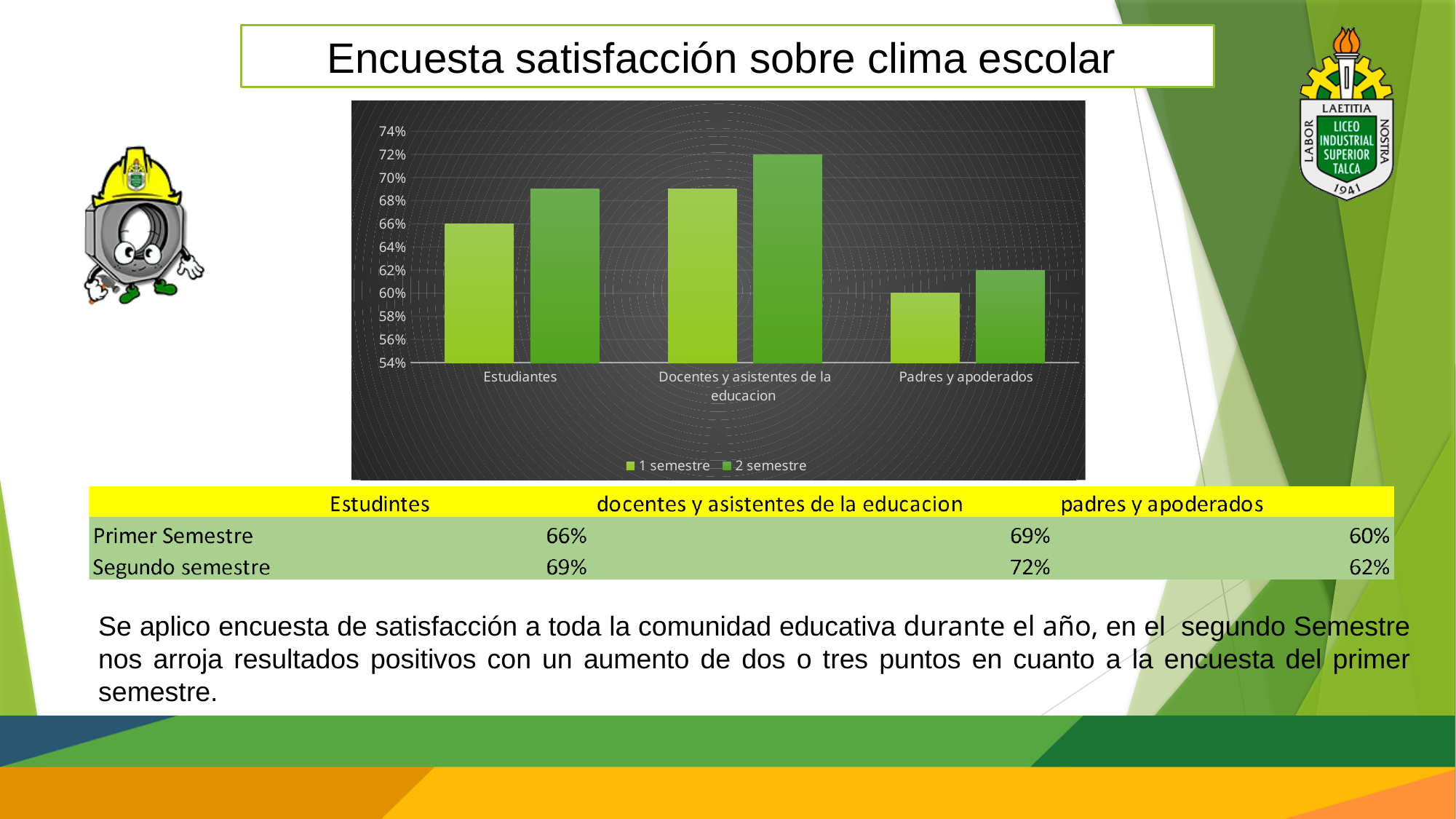
Which category has the lowest value in 1 semestre? Padres y apoderados Which category has the highest value in 2 semestre? Docentes y asistentes de la educacion What is the value for Docentes y asistentes de la educacion in 2 semestre? 72% What is the difference between the 2 semestre and 1 semestre values for Estudiantes? 3% What is the value for Padres y apoderados in 1 semestre? 60% How many categories are shown on the x axis of the chart? 3 How many series does the chart legend list? 2 What type of chart is shown on the slide? bar chart What is the value for Estudiantes in 1 semestre? 66% Which is larger for Padres y apoderados: the 1 semestre value or the 2 semestre value? 2 semestre What are the two entries listed in the chart legend? 1 semestre, 2 semestre Is the 2 semestre value for Docentes y asistentes de la educacion greater or less than 70%? greater